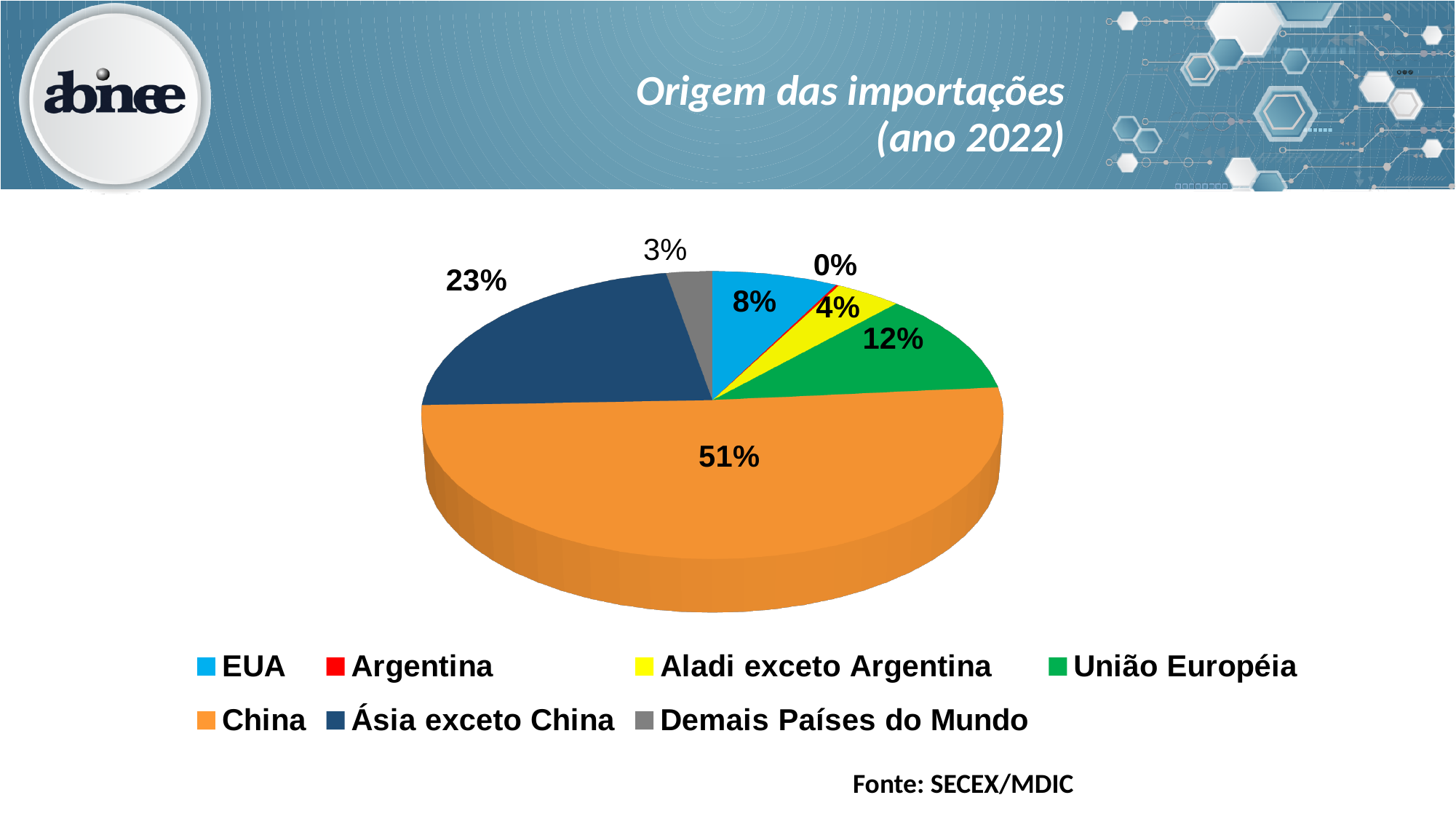
Which origin has the smallest share of imports? Argentina What share of imports comes from Ásia exceto China? 23% What is the difference between the shares of China and Ásia exceto China? 28% What share of imports comes from Aladi exceto Argentina? 4% What kind of chart is shown on the slide? Pie chart What share of imports comes from China? 51% How many origin categories does the legend list? 7 Which origin has the largest share of imports? China Which has a larger share of imports, EUA or União Européia? União Européia